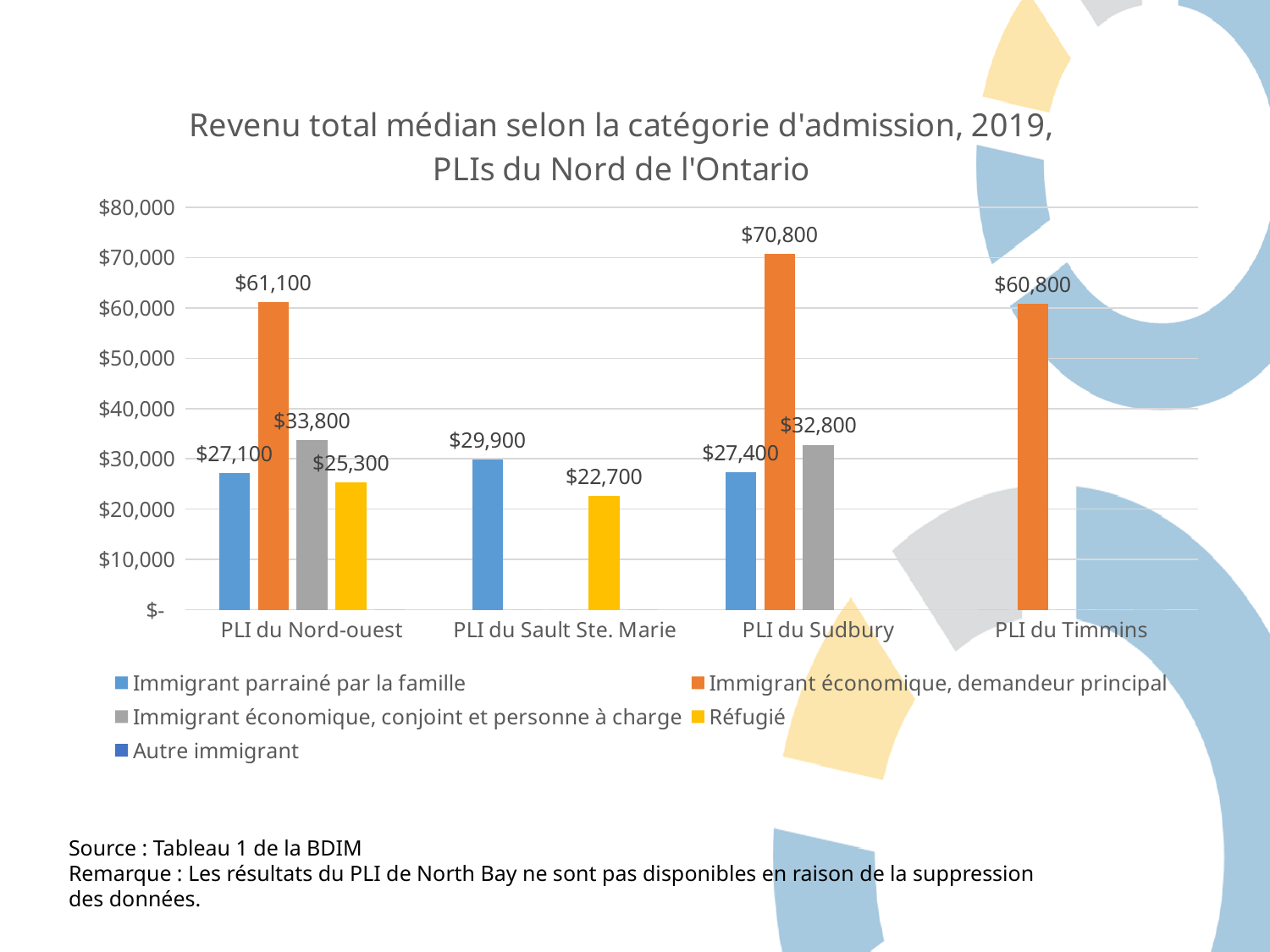
How many PLI categories are shown on the x axis? 4 What is the value for 'Réfugié' in PLI du Sault Ste. Marie? $22,700 What is the value for 'Immigrant économique, conjoint et personne à charge' in PLI du Sudbury? $32,800 How many series does the legend list? 5 Which PLI has the lowest value for 'Immigrant parrainé par la famille'? PLI du Nord-ouest What is the difference between the 'Immigrant économique, demandeur principal' values for PLI du Sudbury and PLI du Nord-ouest? $9,700 Is the value for 'Immigrant économique, demandeur principal' in PLI du Timmins greater or less than $50,000? greater What kind of chart is shown on the slide? Bar chart What is the median total income for 'Immigrant économique, demandeur principal' in PLI du Sudbury? $70,800 Which is larger: the 'Réfugié' value for PLI du Nord-ouest or for PLI du Sault Ste. Marie? PLI du Nord-ouest Which PLI has the highest value for 'Immigrant économique, demandeur principal'? PLI du Sudbury What is the value for 'Immigrant parrainé par la famille' in PLI du Nord-ouest? $27,100